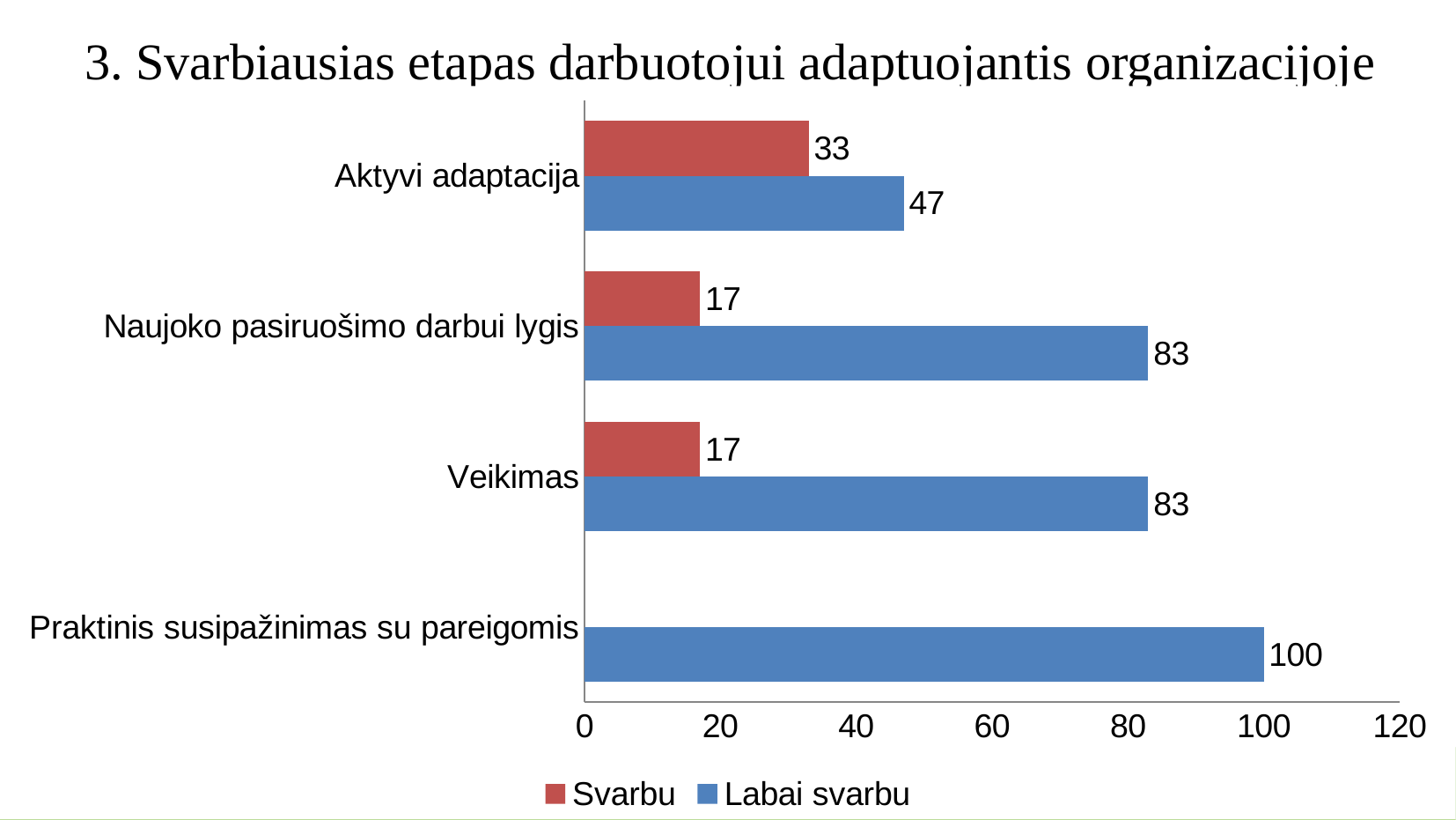
Which category has the highest 'Labai svarbu' value? Praktinis susipažinimas su pareigomis What is the 'Labai svarbu' value for Naujoko pasiruošimo darbui lygis? 83 What kind of chart is shown on the slide? Bar chart What is the 'Svarbu' value for Aktyvi adaptacija? 33 Which colour represents the 'Svarbu' series? Red What is the 'Labai svarbu' value for Praktinis susipažinimas su pareigomis? 100 Which category has the lowest 'Labai svarbu' value? Aktyvi adaptacija How many series does the legend list? 2 What is the 'Svarbu' value for Veikimas? 17 What is the difference between the 'Labai svarbu' and 'Svarbu' values for Aktyvi adaptacija? 14 How many categories are shown on the chart? 4 Which is larger for Veikimas: the 'Svarbu' value or the 'Labai svarbu' value? Labai svarbu